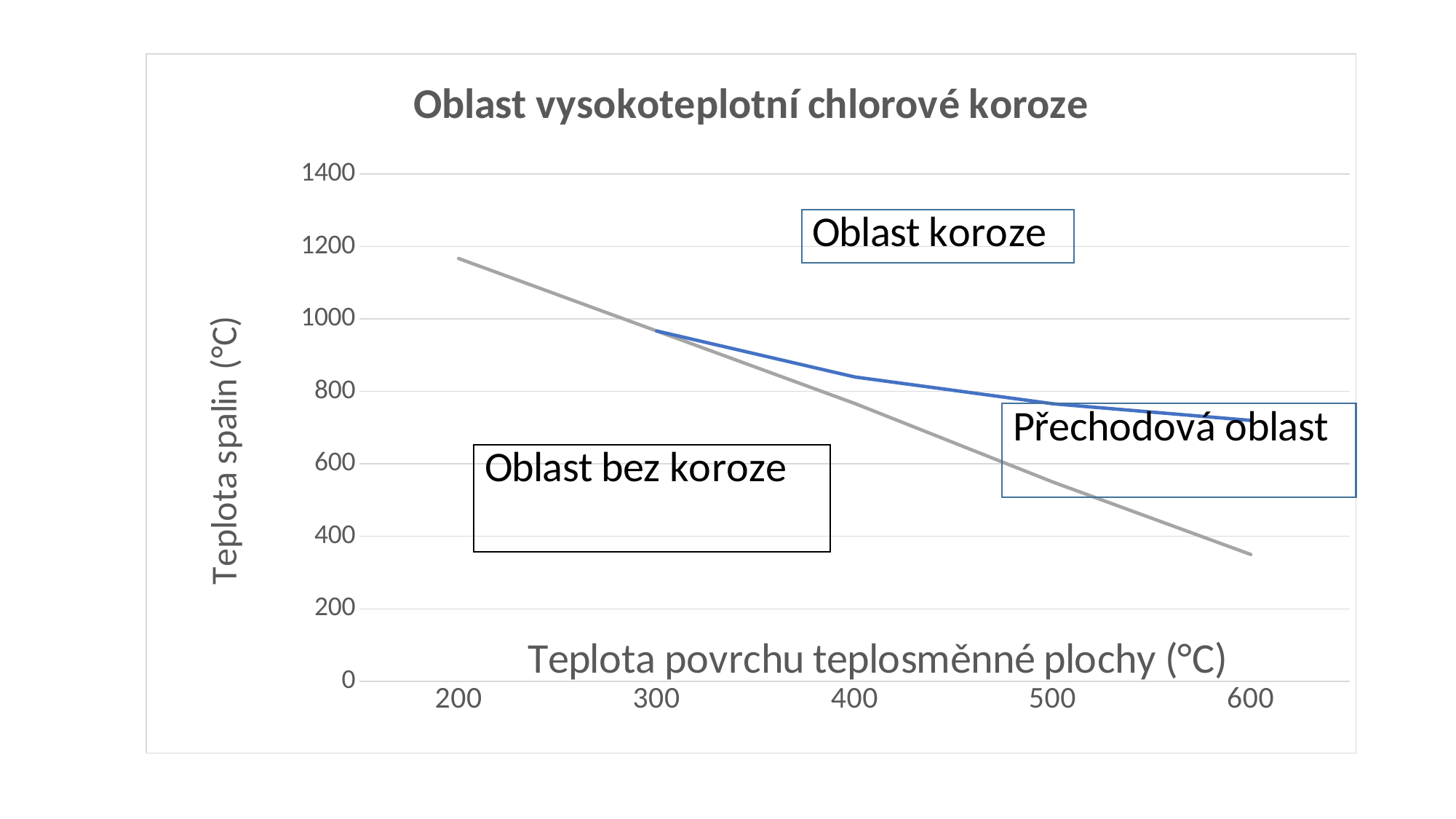
At 600 °C on the x axis, which line has the higher value, the blue line or the gray line? the blue line Is the value of the gray line at 200 °C greater or less than 1000? greater Is the value of the gray line at 600 °C greater or less than 400? less Is the value of the blue line at 600 °C greater or less than 800? less Do the values of the gray line rise or fall as the surface temperature increases along the x axis? fall Do the values of the blue line rise or fall as the surface temperature increases along the x axis? fall What is the title of the chart? Oblast vysokoteplotní chlorové koroze What is the label of the vertical axis? Teplota spalin (°C) How many lines are plotted on the chart? 2 What kind of chart is shown on the slide? line chart